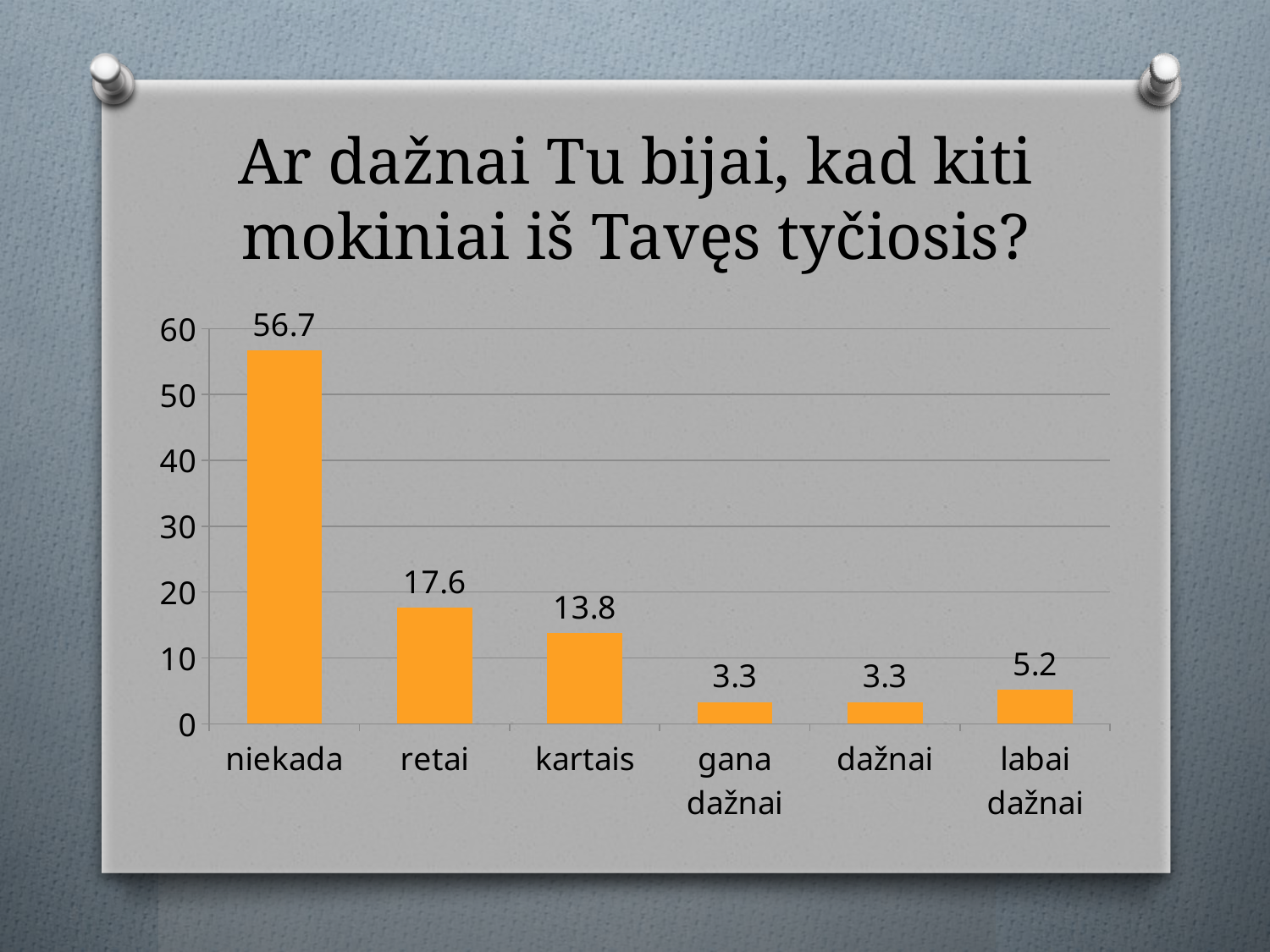
What is the value for "retai"? 17.6 Which is larger, the value for "kartais" or the value for "labai dažnai"? kartais How many categories are shown on the x axis? 6 What is the difference between the values for "niekada" and "retai"? 39.1 What is the value for "niekada"? 56.7 What kind of chart is shown on the slide? bar chart Is the value for "retai" greater or less than 20? less What is the value for "labai dažnai"? 5.2 What is the title of the slide? Ar dažnai Tu bijai, kad kiti mokiniai iš Tavęs tyčiosis? Which category has the highest value? niekada What is the difference between the values for "retai" and "kartais"? 3.8 What is the value for "kartais"? 13.8